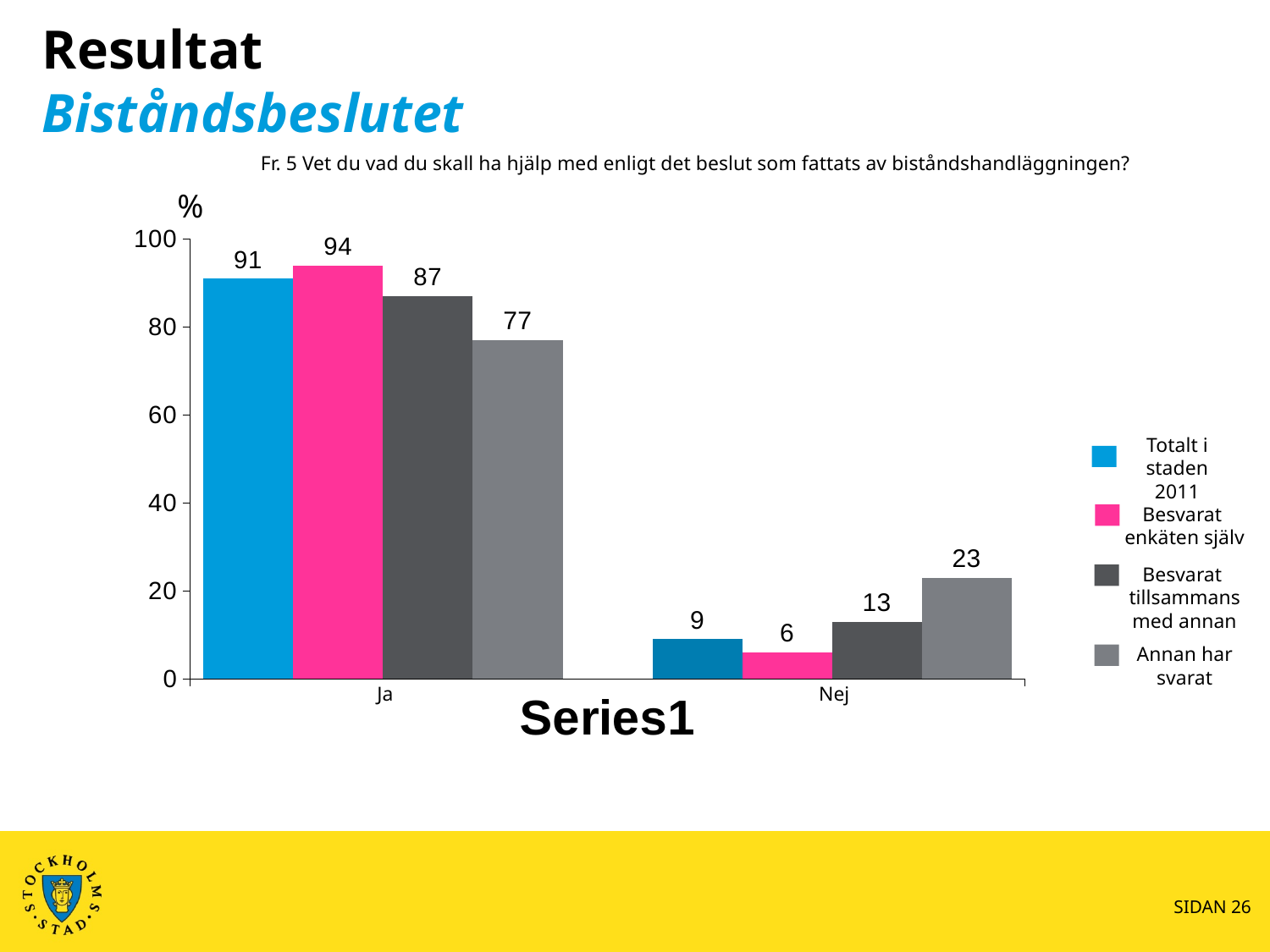
Which series has the highest value in the "Ja" category? Besvarat enkäten själv How many categories are shown on the x axis? 2 Is the value for "Annan har svarat" in the "Nej" category greater or less than 20? greater How many series does the legend list? 4 What is the difference between the "Ja" values for "Totalt i staden 2011" and "Annan har svarat"? 14 What is the value for "Besvarat enkäten själv" in the "Nej" category? 6 What unit is shown at the top of the y axis? % What is the value for "Annan har svarat" in the "Ja" category? 77 What is the value for "Totalt i staden 2011" in the "Ja" category? 91 Which is larger in the "Nej" category: "Besvarat tillsammans med annan" or "Annan har svarat"? Annan har svarat What kind of chart is shown on the slide? Bar chart Which series has the lowest value in the "Nej" category? Besvarat enkäten själv